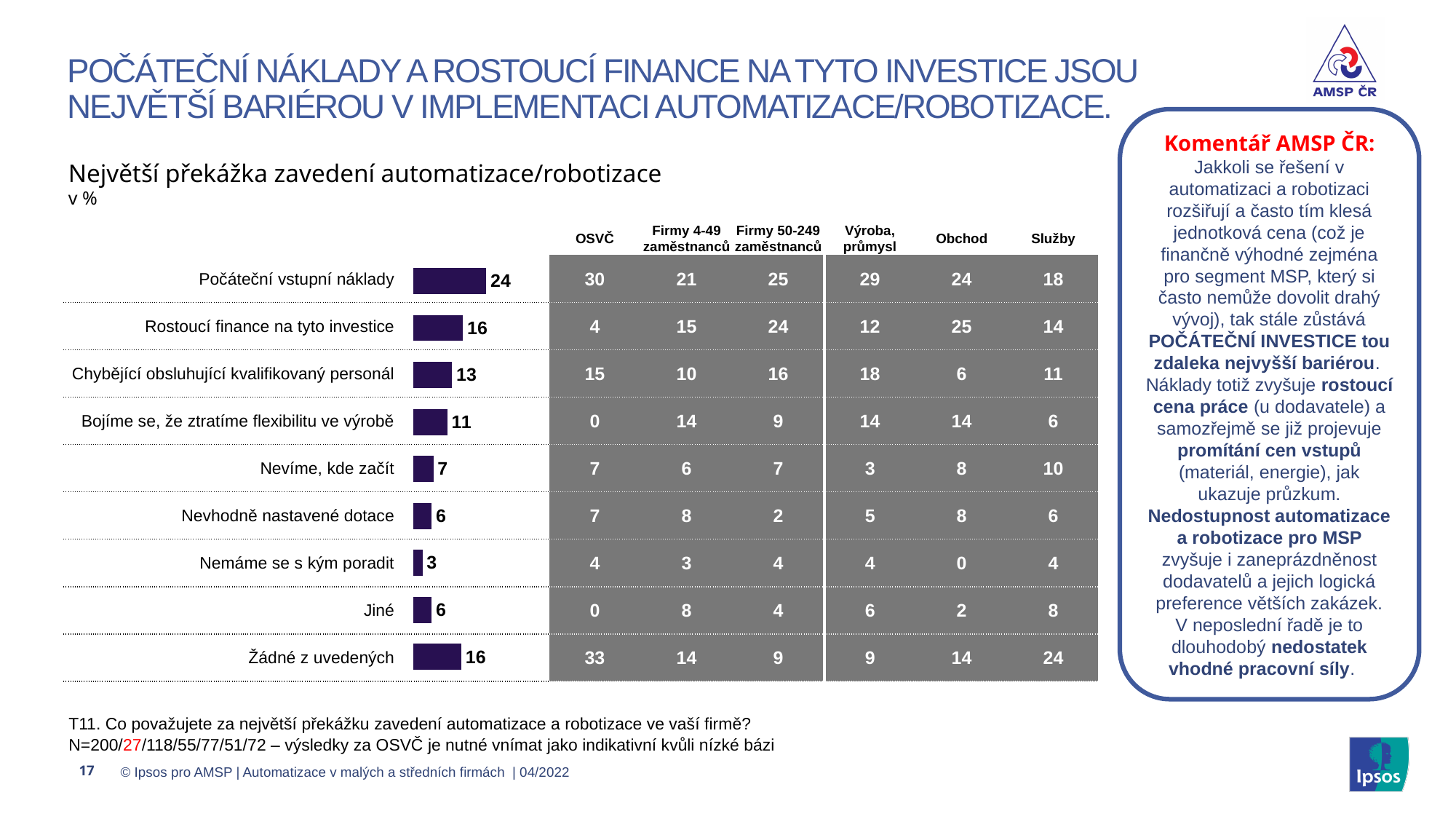
Which is larger in the bar chart: "Bojíme se, že ztratíme flexibilitu ve výrobě" or "Nevhodně nastavené dotace"? Bojíme se, že ztratíme flexibilitu ve výrobě What is the difference between the values for "Počáteční vstupní náklady" and "Rostoucí finance na tyto investice" in the bar chart? 8 What is the title of the chart on the slide? Největší překážka zavedení automatizace/robotizace What is the value for "Chybějící obsluhující kvalifikovaný personál" in the bar chart? 13 What is the value for "Žádné z uvedených" in the bar chart? 16 Which category has the highest value in the bar chart? Počáteční vstupní náklady What is the value for "Nevíme, kde začít" in the bar chart? 7 What is the value for "Počáteční vstupní náklady" in the bar chart? 24 How many categories are shown in the bar chart? 9 What kind of chart is shown on the slide? Bar chart Which category has the lowest value in the bar chart? Nemáme se s kým poradit What is the difference between the values for "Jiné" and "Nemáme se s kým poradit" in the bar chart? 3